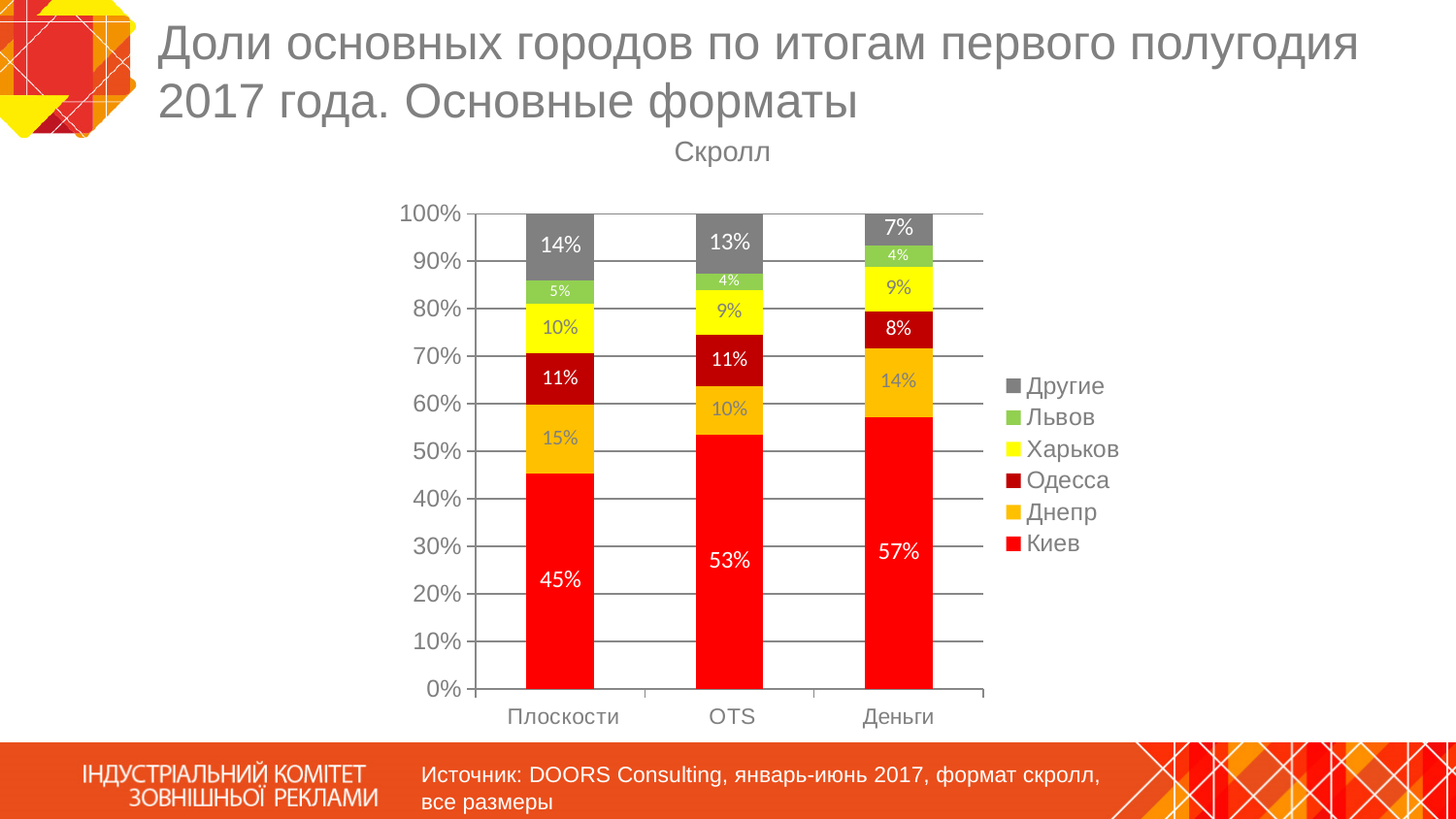
How many categories are shown on the x axis? 3 What is the difference between the Киев values for Деньги and Плоскости? 12% In which category is the value for Киев highest? Деньги Which is larger: the Одесса value for OTS or the Одесса value for Деньги? OTS What kind of chart is shown on the slide? stacked bar chart What is the value for Днепр in the Деньги bar? 14% Does the value for Киев rise or fall from Плоскости to Деньги along the x axis? rise In which category is the value for Другие lowest? Деньги How many series does the legend list? 6 What is the title of the chart? Скролл What is the value for Другие in the OTS bar? 13% What is the value for Киев in the Плоскости bar? 45%